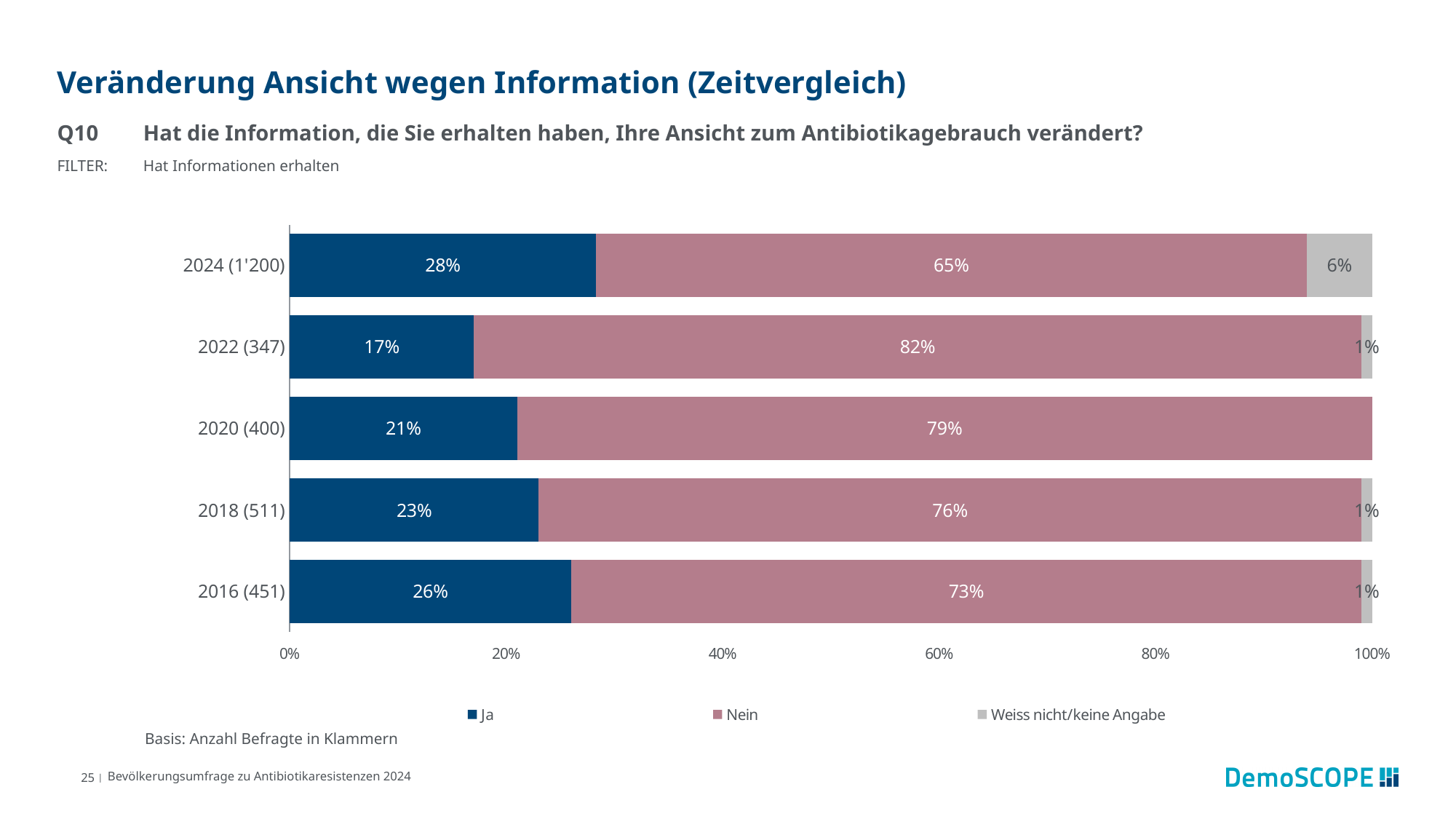
What kind of chart is shown on the slide? Stacked bar chart How many series does the legend list? 3 What is the total of the "Ja" and "Nein" segments for 2020 (400)? 100% How many years (categories) are shown in the chart? 5 What is the value for "Nein" in 2022 (347)? 82% Which legend entry is shown in dark blue? Ja Which year has the lowest value for "Ja"? 2022 (347) What is the value for "Weiss nicht/keine Angabe" in 2024 (1'200)? 6% What is the difference between the "Nein" values for 2022 (347) and 2024 (1'200)? 17 percentage points Which year has the highest value for "Ja"? 2024 (1'200) What is the value for "Ja" in 2024 (1'200)? 28% Which is larger: the "Ja" value for 2016 (451) or for 2018 (511)? 2016 (451)